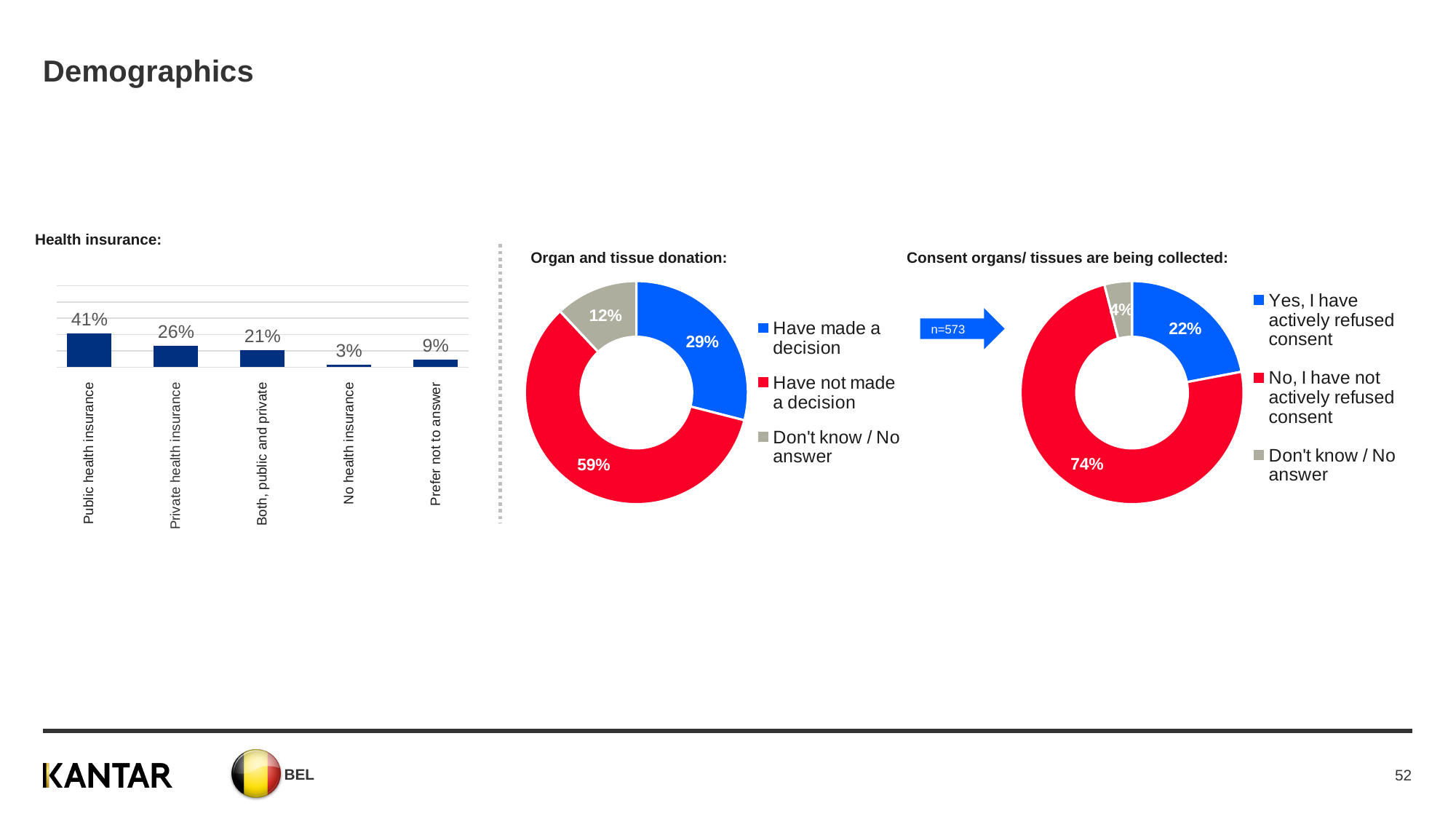
How many entries does the legend of the 'Organ and tissue donation' chart list? 3 In the 'Organ and tissue donation' chart, what share is 'Have made a decision'? 29% In the 'Health insurance' chart, how many categories are shown? 5 In the 'Health insurance' chart, which category has the highest value? Public health insurance What kind of chart is the 'Health insurance' chart? Bar chart In the 'Health insurance' chart, what is the value for Both, public and private? 21% In the 'Consent organs/ tissues are being collected' chart, what share is 'No, I have not actively refused consent'? 74% In the 'Health insurance' chart, what is the difference between Public health insurance and Private health insurance? 15% In the 'Health insurance' chart, what is the value for Public health insurance? 41% In the 'Organ and tissue donation' chart, what share is 'Have not made a decision'? 59% In the 'Health insurance' chart, which category has the lowest value? No health insurance In the 'Consent organs/ tissues are being collected' chart, which is larger: 'Yes, I have actively refused consent' or 'Don't know / No answer'? Yes, I have actively refused consent